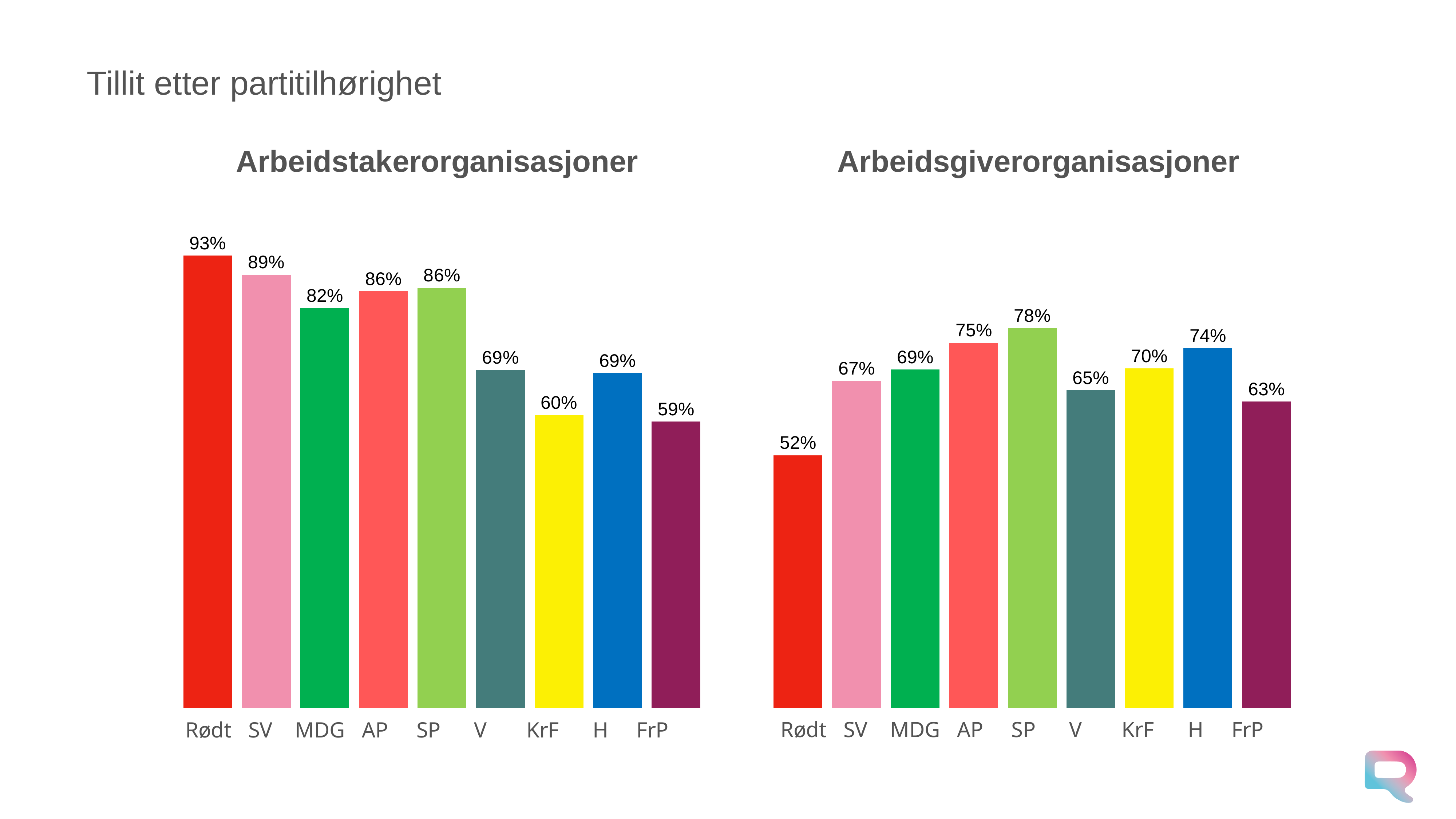
How many parties are shown in the Arbeidsgiverorganisasjoner chart? 9 In the Arbeidstakerorganisasjoner chart, which is larger, the value for SV or the value for MDG? SV In the Arbeidsgiverorganisasjoner chart, which party has the highest value? SP In the Arbeidstakerorganisasjoner chart, which party has the lowest value? FrP What kind of chart is the Arbeidstakerorganisasjoner chart? Bar chart In the Arbeidsgiverorganisasjoner chart, which party has the lowest value? Rødt In the Arbeidsgiverorganisasjoner chart, what is the value for KrF? 70% In the Arbeidstakerorganisasjoner chart, which party has the highest value? Rødt In the Arbeidsgiverorganisasjoner chart, what is the value for SP? 78% In the Arbeidsgiverorganisasjoner chart, what is the difference between the values for H and Rødt? 22 percentage points In the Arbeidstakerorganisasjoner chart, what is the value for Rødt? 93% In the Arbeidstakerorganisasjoner chart, what is the difference between the values for Rødt and FrP? 34 percentage points